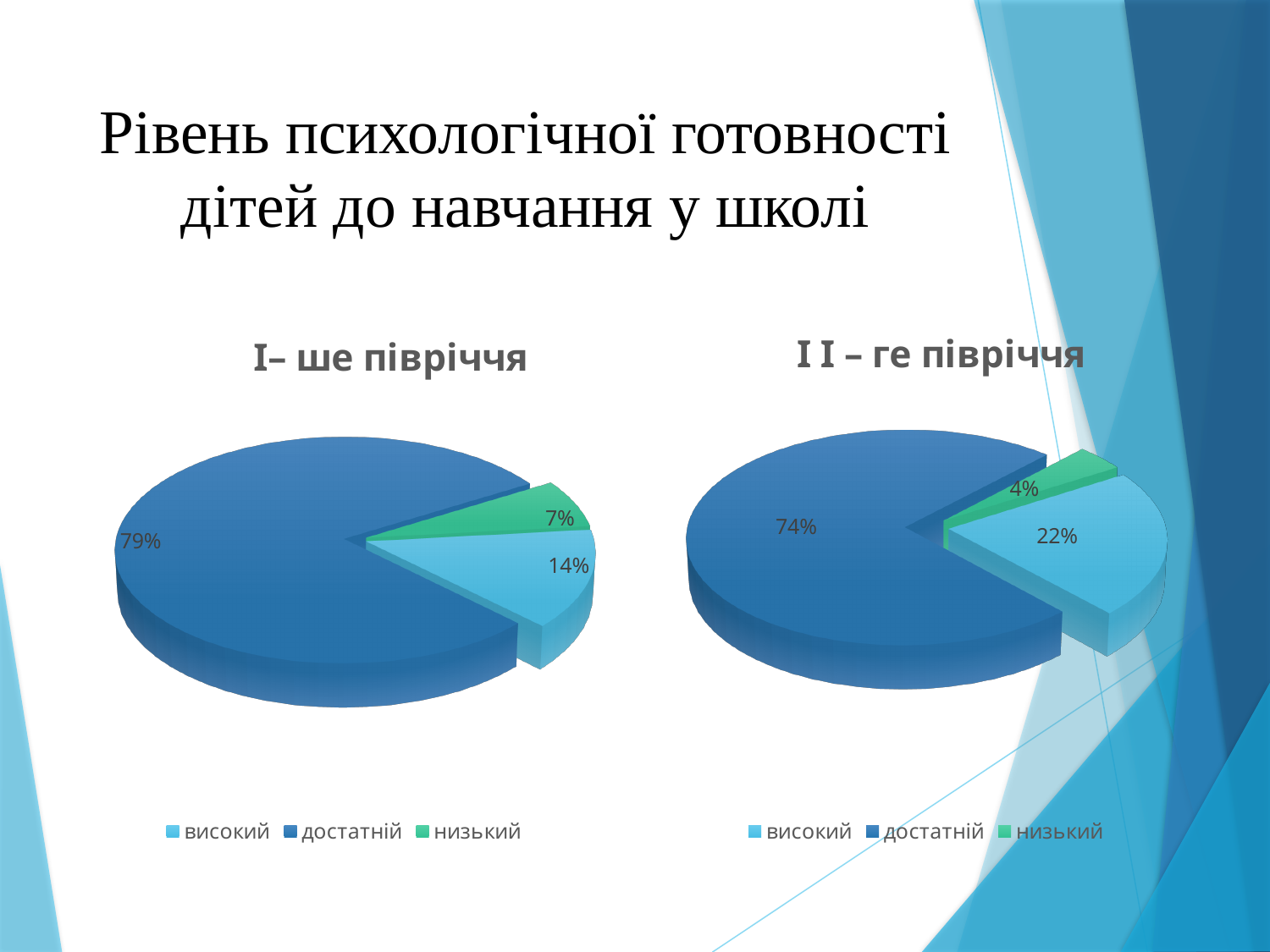
In the chart titled "І– ше півріччя", what share is labelled for the "достатній" slice? 79% What is the difference between the "високий" share in the "І І – ге півріччя" chart and the "високий" share in the "І– ше півріччя" chart? 8% In the chart titled "І І – ге півріччя", which category has the largest slice? достатній In the chart titled "І– ше півріччя", what share is labelled for the "високий" slice? 14% In the chart titled "І– ше півріччя", which category has the smallest slice? низький In the chart titled "І І – ге півріччя", what share is labelled for the "низький" slice? 4% In the chart titled "І І – ге півріччя", what share is labelled for the "високий" slice? 22% How many slices does the chart titled "І– ше півріччя" have? 3 What type of chart is the one titled "І І – ге півріччя"? Pie chart How many entries does the legend of the chart titled "І І – ге півріччя" list? 3 Which is larger: the "достатній" share in the "І– ше півріччя" chart or the "достатній" share in the "І І – ге півріччя" chart? І– ше півріччя In the chart titled "І– ше півріччя", what share is labelled for the "низький" slice? 7%